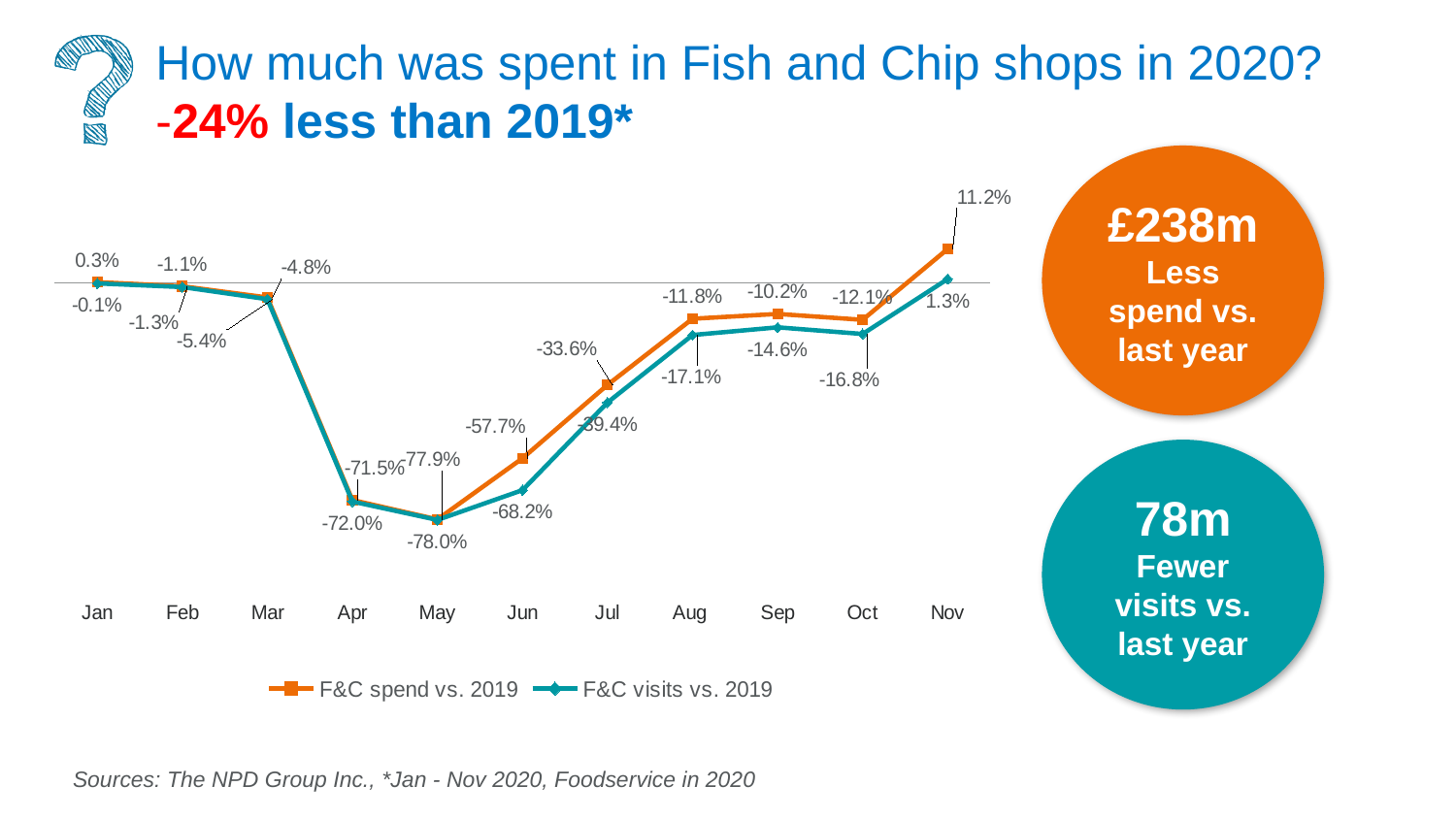
What is the value of F&C spend vs. 2019 in Nov? 11.2% How many months are plotted on the x axis? 11 In which month is F&C spend vs. 2019 at its highest? Nov From May to Nov, does F&C spend vs. 2019 rise or fall? Rise In Aug, what is the difference between F&C spend vs. 2019 and F&C visits vs. 2019? 5.3 percentage points How many series does the legend list? 2 What is the value of F&C visits vs. 2019 in Jun? -68.2% What is the value of F&C spend vs. 2019 in Sep? -10.2% What kind of chart is shown on the slide? Line chart In Jul, which is higher: F&C spend vs. 2019 or F&C visits vs. 2019? F&C spend vs. 2019 In which month is F&C visits vs. 2019 at its lowest? May Which series is drawn in orange? F&C spend vs. 2019